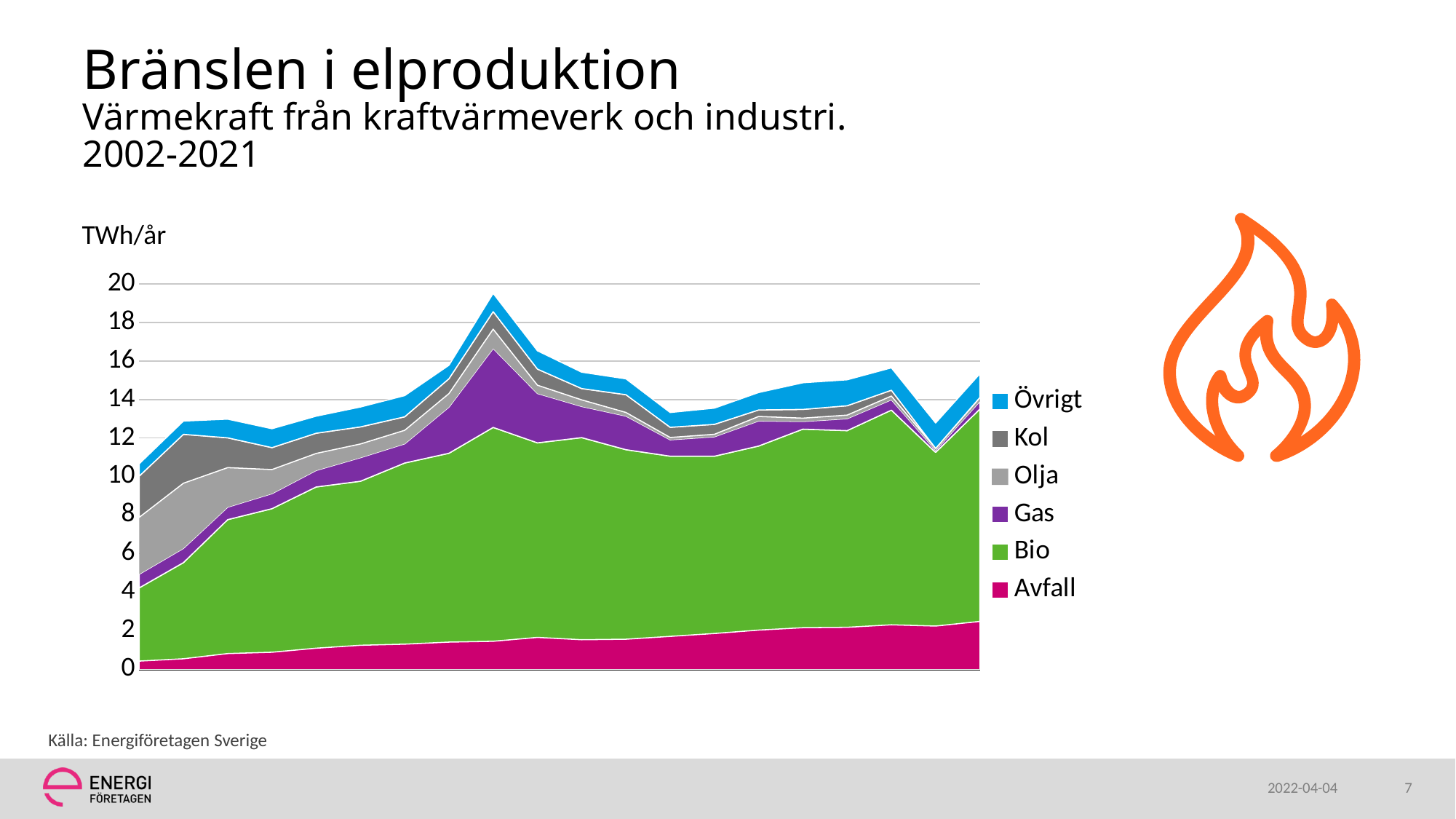
Does the Avfall series rise or fall from the left to the right of the chart? Rises Is the highest stacked total in the chart greater or less than 18? greater Which is larger at the leftmost point of the chart, the Bio value or the Avfall value? Bio Is the stacked total at the leftmost point of the chart greater or less than 12? less Which series accounts for the largest share of the stacked total across the chart? Bio Is the Avfall value at the rightmost point of the chart greater or less than 4? less What unit is shown on the y axis of the chart? TWh/år Which series are listed in the legend? Övrigt, Kol, Olja, Gas, Bio, Avfall What kind of chart is shown on the slide? Stacked area chart Does the Kol series rise or fall from the left to the right of the chart? Falls How many series does the legend list? 6